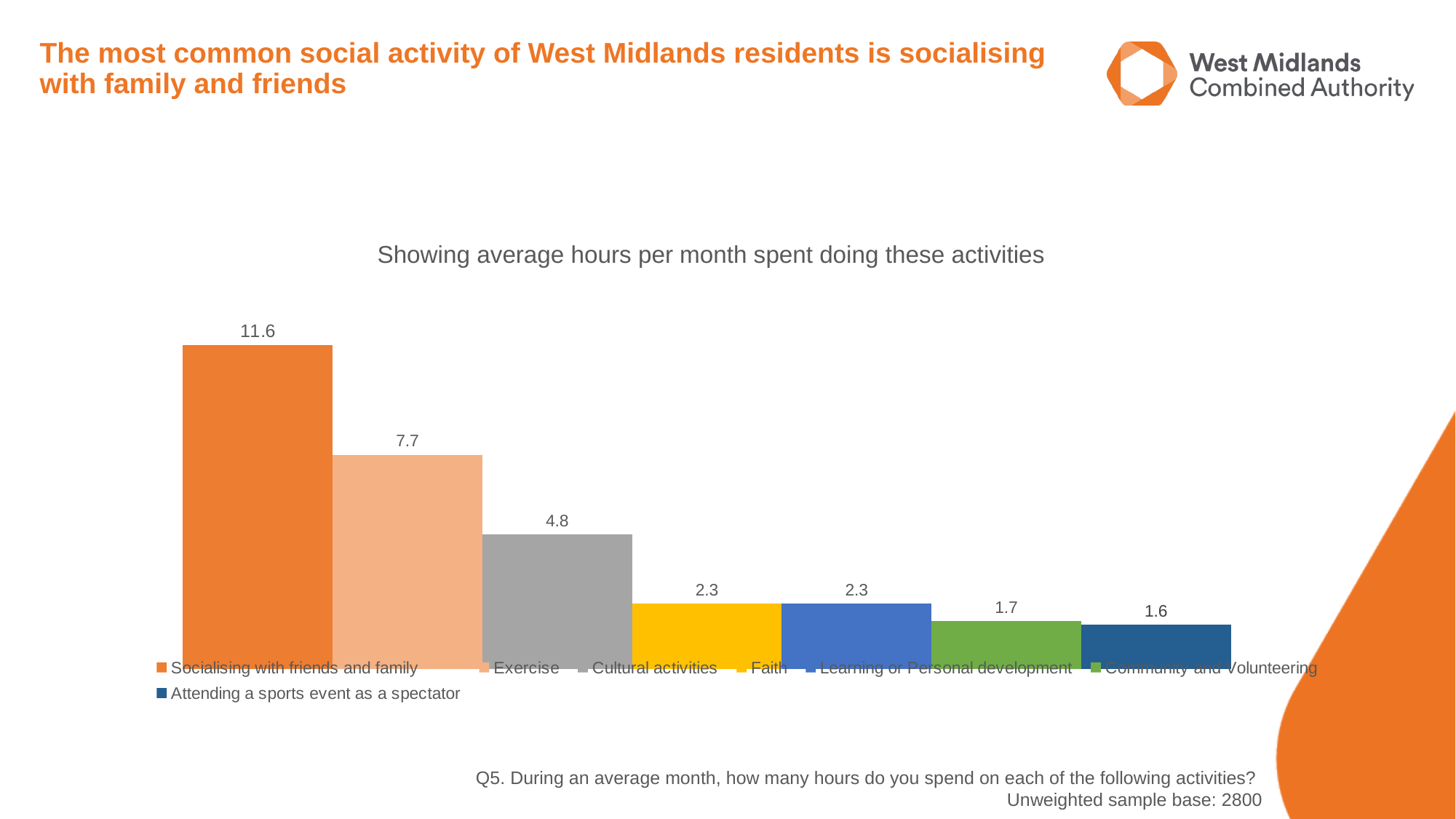
What is the value shown for Exercise? 7.7 What is the value shown for Cultural activities? 4.8 How many entries does the legend list? 7 Which activity has the highest average hours per month? Socialising with friends and family What kind of chart is shown on the slide? Bar chart What is the difference between the values for Cultural activities and Faith? 2.5 Which is larger, the value for Exercise or the value for Cultural activities? Exercise Which activity has the lowest average hours per month? Attending a sports event as a spectator How many bars are plotted in the chart? 7 What is the value shown for Attending a sports event as a spectator? 1.6 What is the average hours per month for Socialising with friends and family? 11.6 What is the difference between the values for Socialising with friends and family and Exercise? 3.9